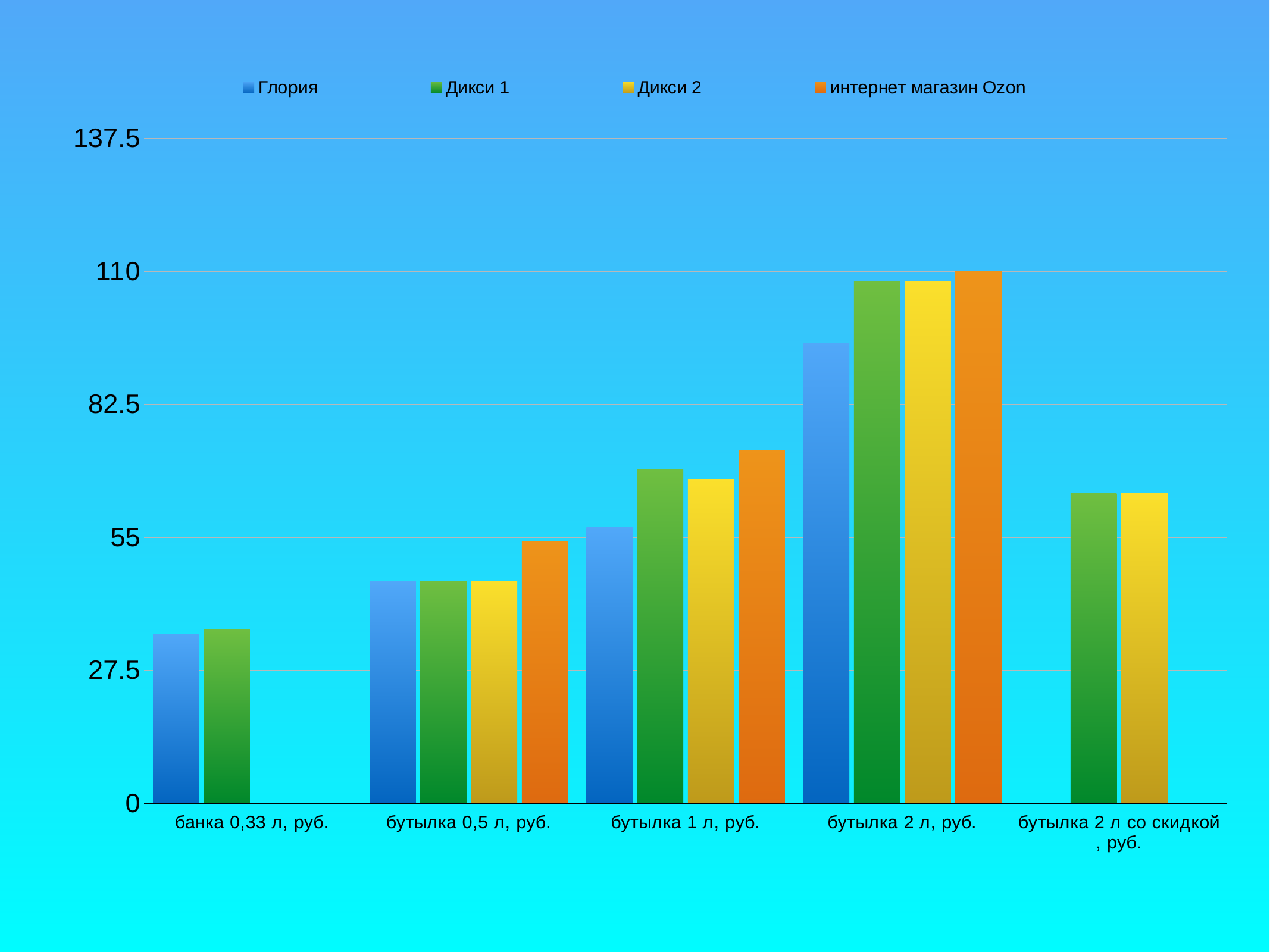
Is the value for Глория in the бутылка 2 л, руб. category greater or less than 82.5? greater Is the value for Глория in the банка 0,33 л, руб. category greater or less than 27.5? greater Is the value for Дикси 1 in the бутылка 1 л, руб. category greater or less than 82.5? less Which series has the lowest bar in the бутылка 2 л, руб. category? Глория Which series has the lowest bar in the бутылка 1 л, руб. category? Глория Which series is shown in orange in the legend? интернет магазин Ozon How many series does the legend list? 4 What kind of chart is shown on the slide? bar chart Which series has the highest bar in the бутылка 1 л, руб. category? интернет магазин Ozon Which is larger for Глория: the value for бутылка 1 л, руб. or the value for бутылка 2 л, руб.? бутылка 2 л, руб. How many categories are shown on the x axis? 5